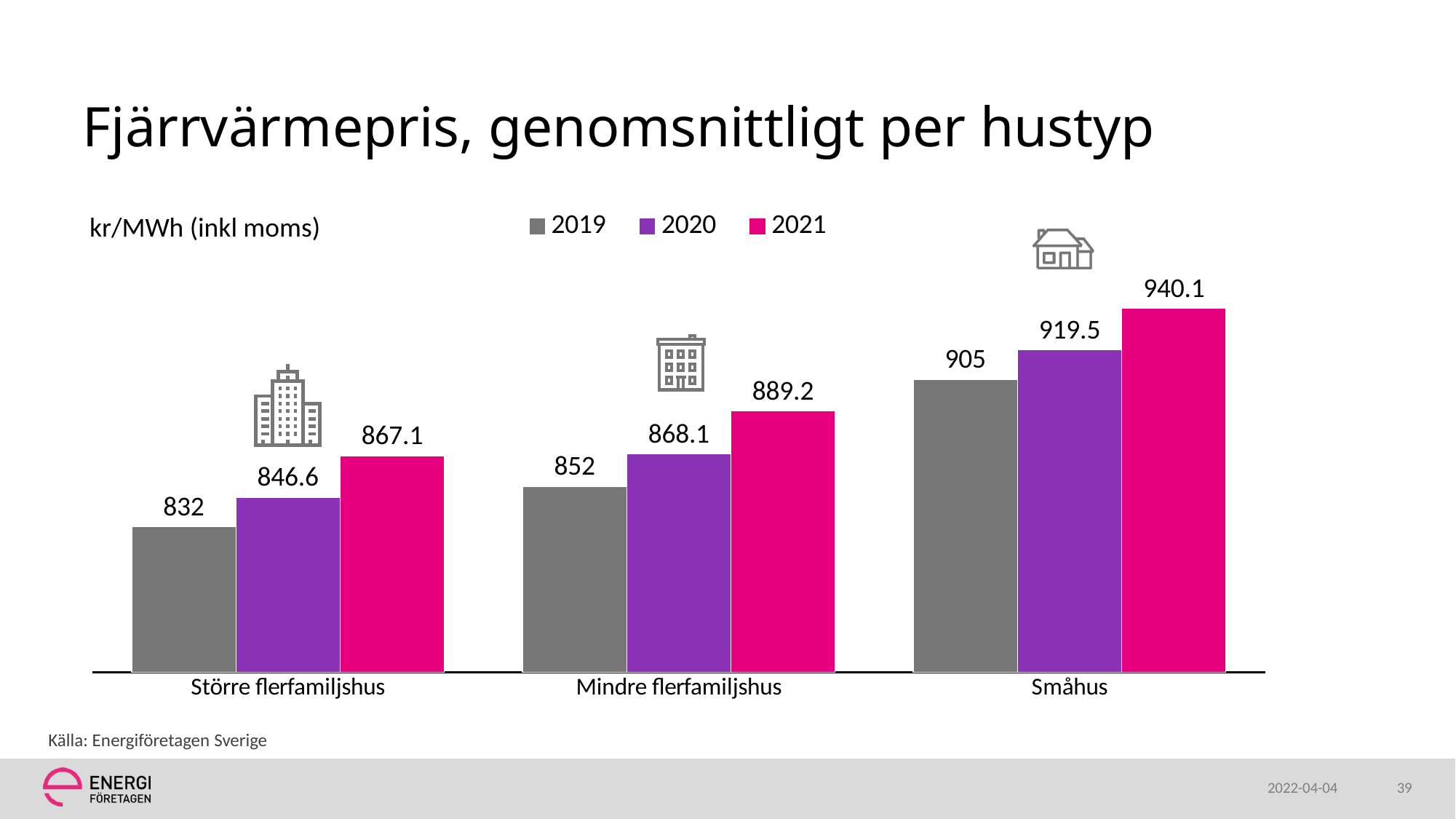
What is the difference between the 2021 and 2019 values for Småhus? 35.1 What is the 2020 value for Mindre flerfamiljshus? 868.1 What is the 2019 value for Större flerfamiljshus? 832 How many categories are shown on the x axis? 3 What unit is given for the values in the chart? kr/MWh (inkl moms) What kind of chart is shown on the slide? Bar chart Which category has the lowest 2019 value? Större flerfamiljshus Which is larger: the 2021 value for Större flerfamiljshus or the 2019 value for Mindre flerfamiljshus? 2021 value for Större flerfamiljshus What is the difference between the 2020 values for Mindre flerfamiljshus and Större flerfamiljshus? 21.5 Which category has the highest 2021 value? Småhus What is the 2021 value for Småhus? 940.1 How many series does the legend list? 3